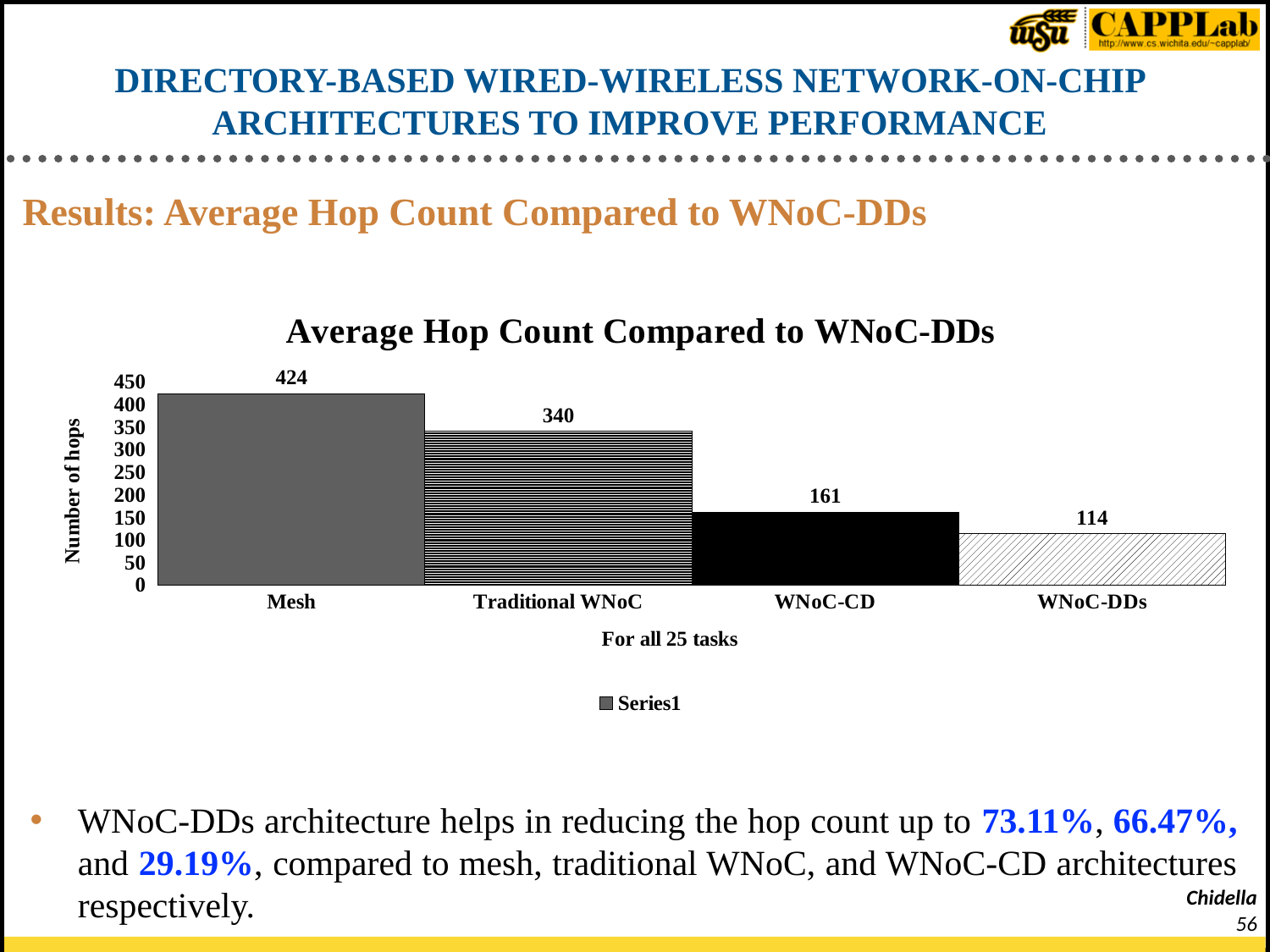
What is the difference between the values for Mesh and WNoC-DDs? 310 What is the value for Mesh? 424 How many categories are shown on the x axis? 4 Which category has the highest number of hops? Mesh What is the value for WNoC-CD? 161 What kind of chart is shown on the slide? Bar chart What is the title of the chart? Average Hop Count Compared to WNoC-DDs Which is larger, the value for WNoC-CD or the value for WNoC-DDs? WNoC-CD Which category has the lowest number of hops? WNoC-DDs What is the difference between the values for Traditional WNoC and WNoC-CD? 179 What is the value for Traditional WNoC? 340 What is the value for WNoC-DDs? 114